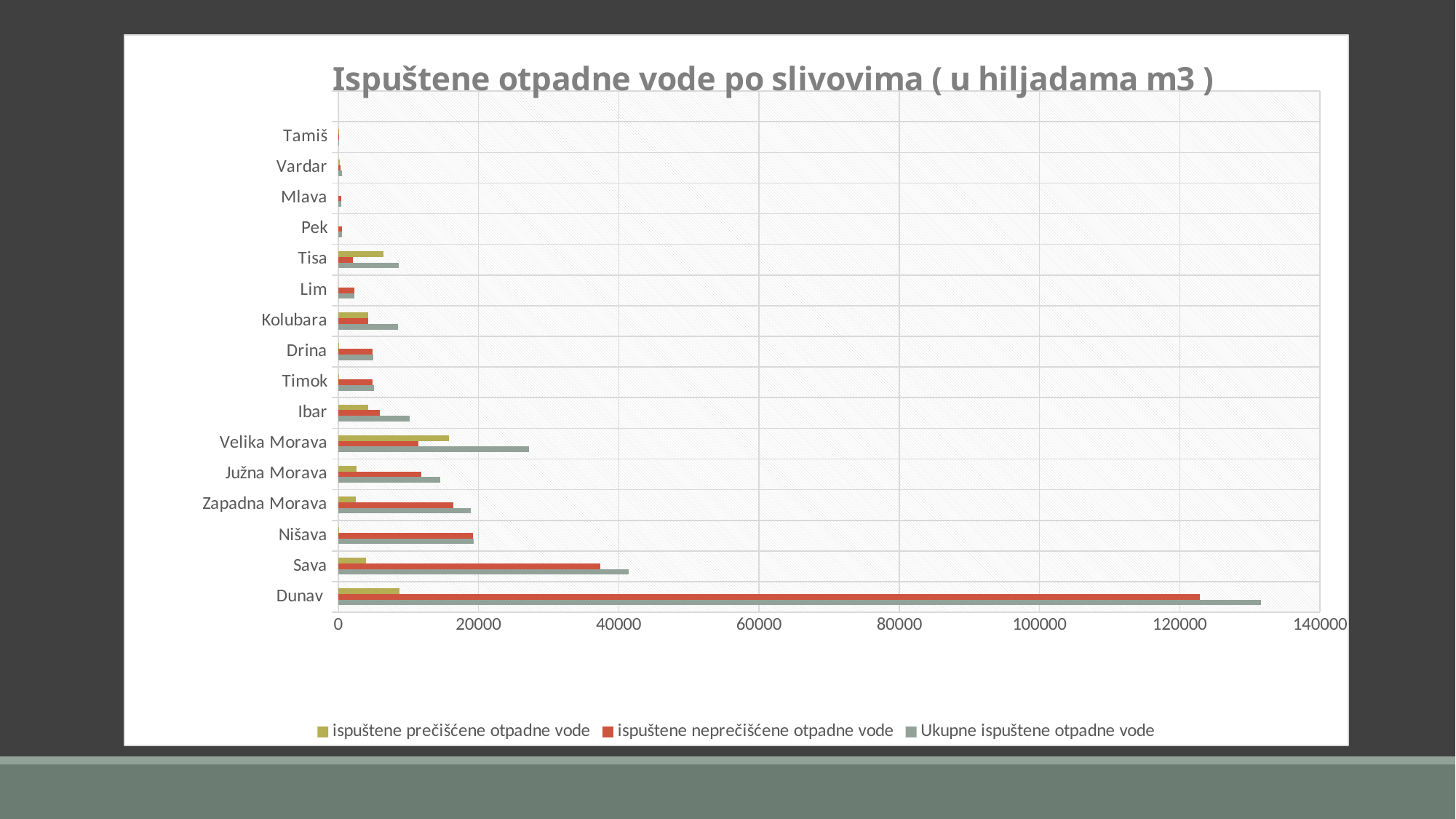
Which basin has the highest value for ispuštene prečišćene otpadne vode? Velika Morava Is the value of ispuštene prečišćene otpadne vode for Velika Morava greater or less than 20000? less What is the title of the chart? Ispuštene otpadne vode po slivovima ( u hiljadama m3 ) How many river basins (categories) are shown on the chart? 16 Which basin has the highest value for Ukupne ispuštene otpadne vode? Dunav Is the value of Ukupne ispuštene otpadne vode for Dunav greater or less than 120000? greater Is the value of ispuštene neprečišćene otpadne vode for Sava greater or less than 40000? less Which is larger, the Ukupne ispuštene otpadne vode value for Sava or for Velika Morava? Sava Which is larger, the ispuštene prečišćene otpadne vode value for Dunav or for Sava? Dunav How many series does the legend list? 3 What kind of chart is shown on the slide? bar chart